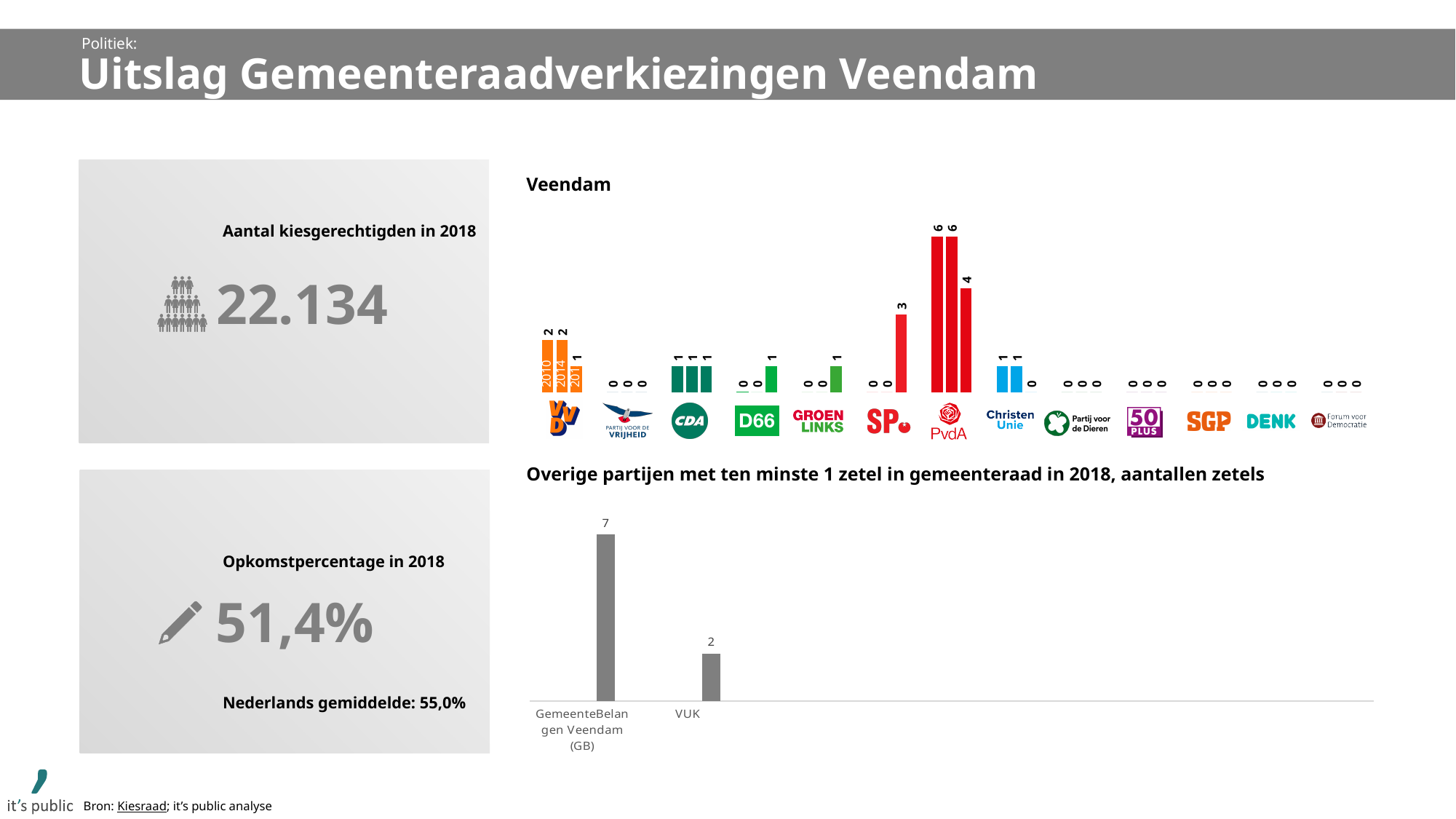
In the top 'Veendam' chart, did the number of seats for VVD rise or fall from 2010 to 2018? fall In the top 'Veendam' chart, how many seats did SP have in 2018? 3 In the top 'Veendam' chart, how many seats did PvdA have in 2010? 6 In the bottom chart 'Overige partijen met ten minste 1 zetel in gemeenteraad in 2018', how many seats does VUK have? 2 How many parties are shown in the bottom chart 'Overige partijen met ten minste 1 zetel in gemeenteraad in 2018'? 2 In the top 'Veendam' chart, how many seats did PvdA have in 2018? 4 In the bottom chart 'Overige partijen met ten minste 1 zetel in gemeenteraad in 2018', which party has the most seats? GemeenteBelangen Veendam (GB) What type of chart is the bottom chart 'Overige partijen met ten minste 1 zetel in gemeenteraad in 2018'? bar chart In the bottom chart 'Overige partijen met ten minste 1 zetel in gemeenteraad in 2018', what is the difference in seats between GemeenteBelangen Veendam (GB) and VUK? 5 In the top 'Veendam' chart, which had more seats in 2018, SP or CDA? SP In the top 'Veendam' chart, which party had the most seats in 2018? PvdA In the bottom chart 'Overige partijen met ten minste 1 zetel in gemeenteraad in 2018', how many seats does GemeenteBelangen Veendam (GB) have? 7